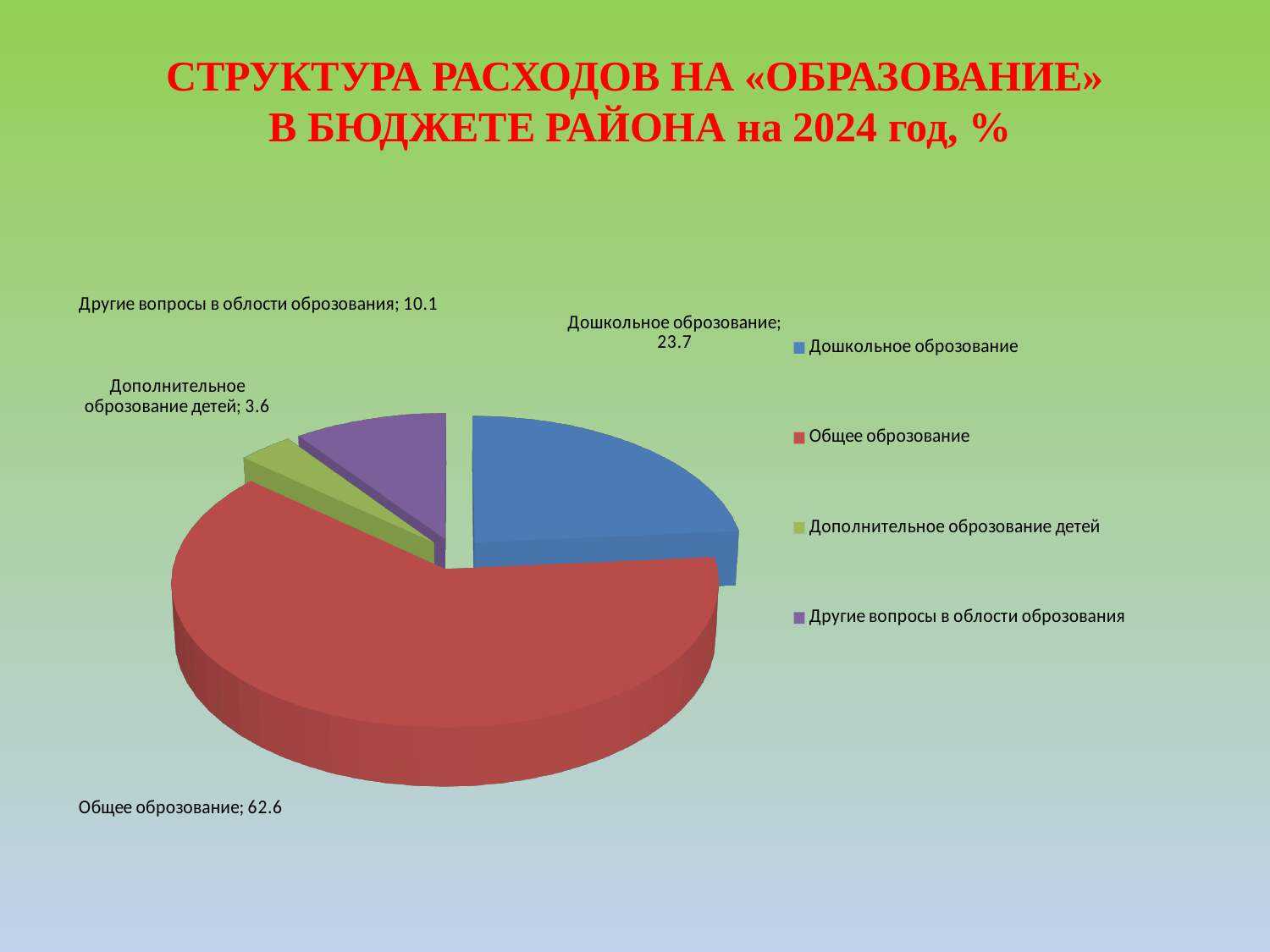
Which category has the largest share of the pie? Общее оброзование Which is larger: Дошкольное оброзование or Другие вопросы в области оброзования? Дошкольное оброзование How many categories does the pie chart have? 4 Which category has the smallest share of the pie? Дополнительное оброзование детей What is the difference between the values for Другие вопросы в области оброзования and Дополнительное оброзование детей? 6.5 What is the value for Общее оброзование? 62.6 What is the value for Дошкольное оброзование? 23.7 What colour is the slice for Общее оброзование? Red What is the difference between the values for Общее оброзование and Дошкольное оброзование? 38.9 What is the value for Другие вопросы в области оброзования? 10.1 What kind of chart is shown on the slide? Pie chart What is the value for Дополнительное оброзование детей? 3.6